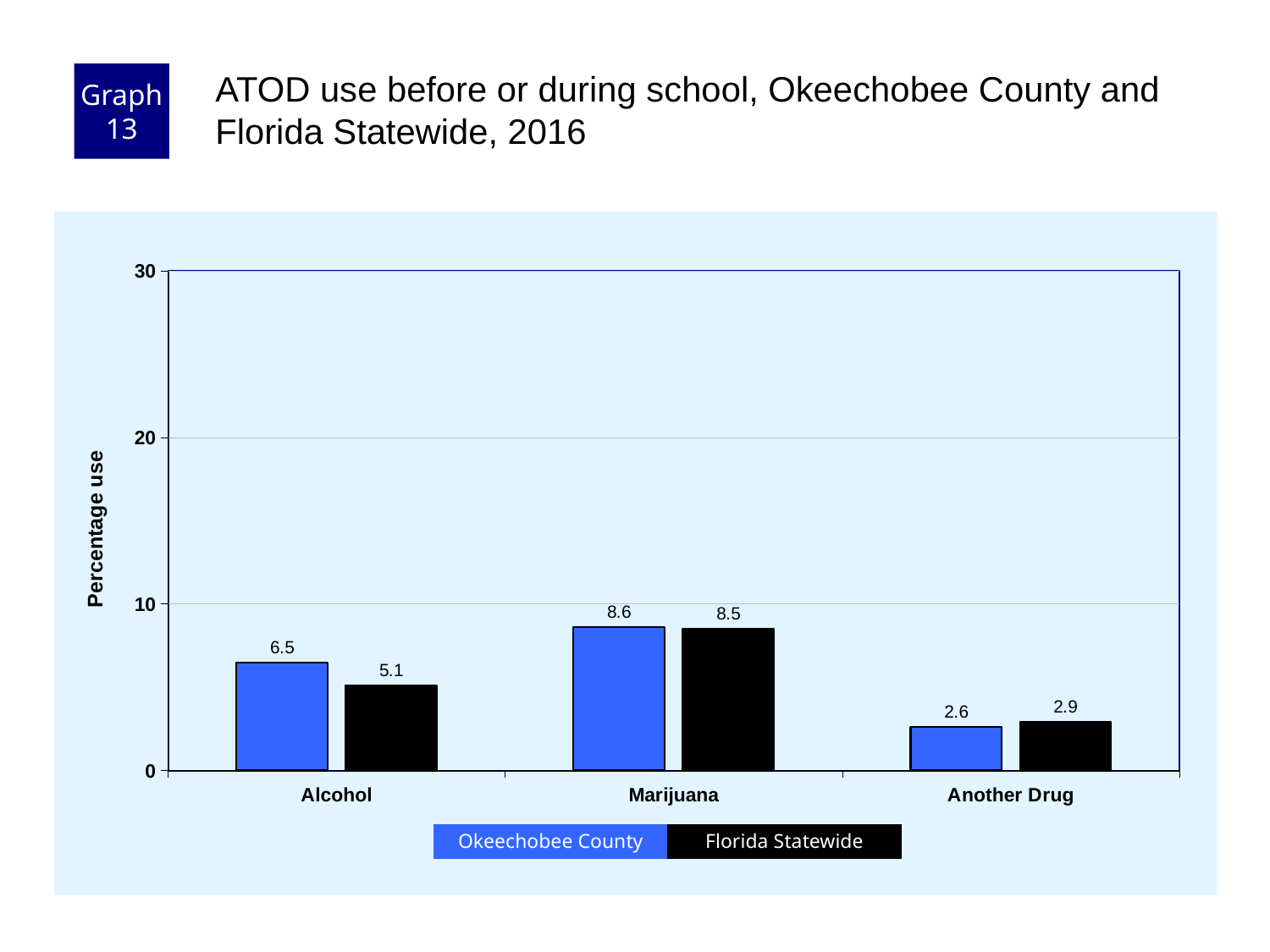
What is the Okeechobee County value for Alcohol? 6.5 Which category has the lowest Florida Statewide value? Another Drug Is the Florida Statewide value for Marijuana greater or less than 10? less What is the Okeechobee County value for Another Drug? 2.6 What is the difference between the Okeechobee County and Florida Statewide values for Alcohol? 1.4 How many series does the legend list? 2 Which category has the highest Okeechobee County value? Marijuana How many categories are shown on the x axis? 3 What is the Florida Statewide value for Marijuana? 8.5 What kind of chart is shown on the slide? bar chart What is the label of the y axis? Percentage use For Another Drug, which is larger: Okeechobee County or Florida Statewide? Florida Statewide